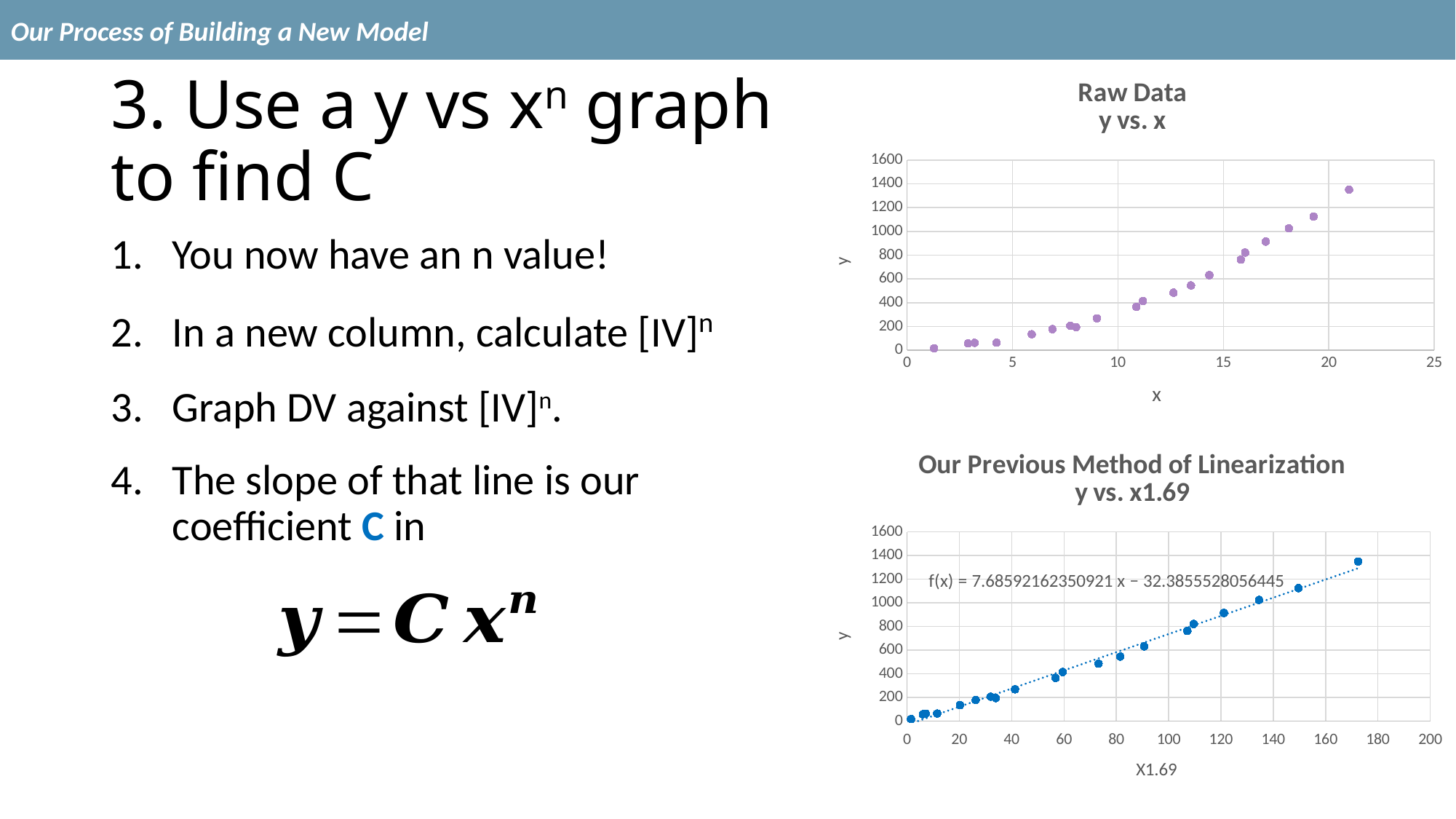
How many charts are shown on the slide? 2 What is the trendline equation shown on the 'Our Previous Method of Linearization' chart? f(x) = 7.68592162350921 x − 32.3855528056445 In the 'Our Previous Method of Linearization' chart, is the y value of the rightmost point greater or less than 1200? greater What kind of chart is the 'Raw Data y vs. x' chart? scatter chart In the 'Raw Data y vs. x' chart, do the y values rise or fall as x increases? rise In the 'Raw Data y vs. x' chart, what is the maximum value shown on the y axis? 1600 In the 'Raw Data y vs. x' chart, is the highest plotted y value greater or less than 1200? greater In the 'Our Previous Method of Linearization' chart, is the y value of the point near x = 60 greater or less than 600? less In the 'Our Previous Method of Linearization' chart, do the y values rise or fall along the x axis? rise What kind of chart is the 'Our Previous Method of Linearization' chart? scatter chart What is the x-axis label of the 'Our Previous Method of Linearization' chart? X1.69